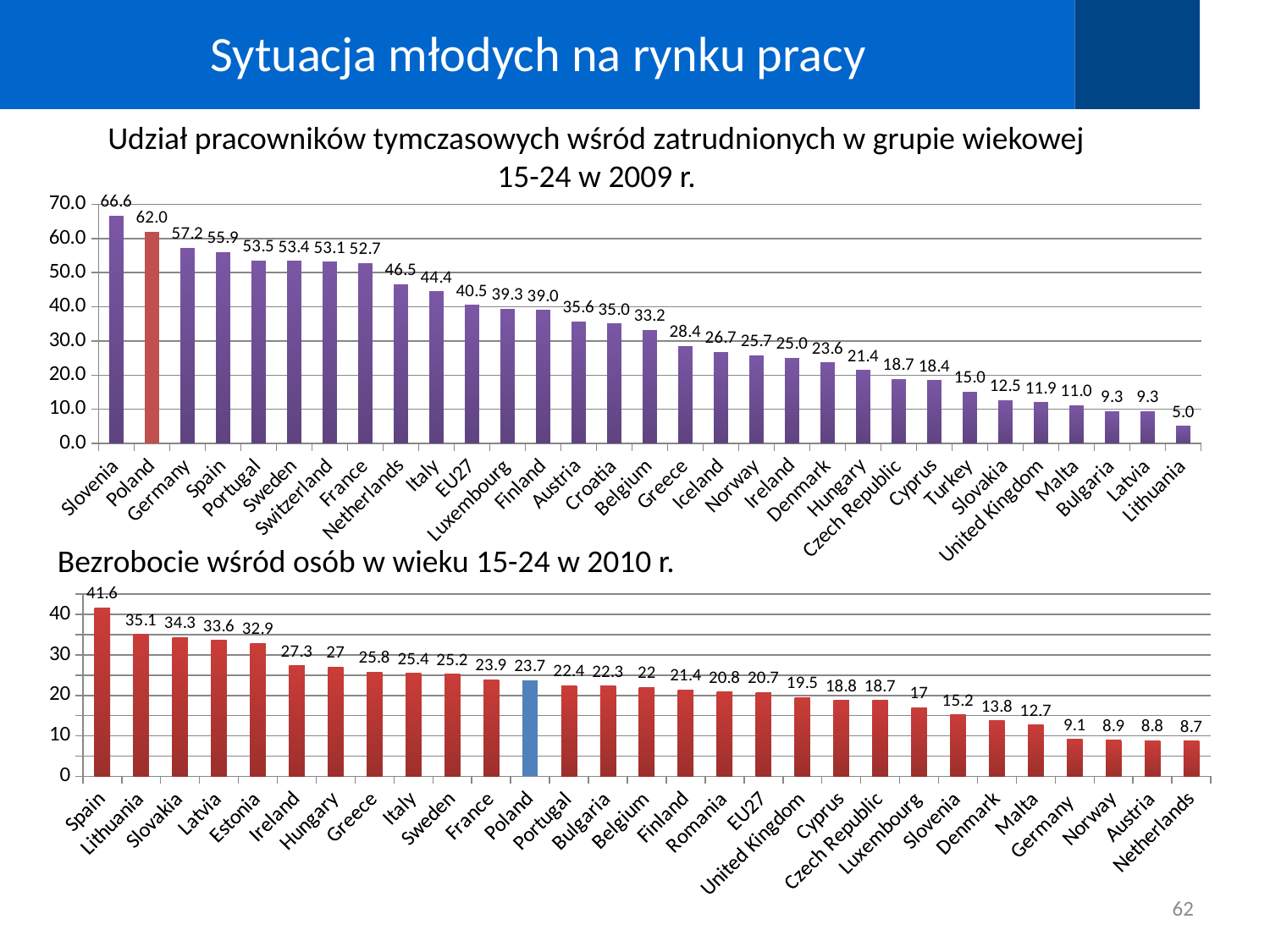
In the top chart (temporary workers share, 15-24, 2009), which country has the lowest value? Lithuania In the bottom chart (youth unemployment 15-24, 2010), what is the value for Poland? 23.7 In the top chart (temporary workers share, 15-24, 2009), what is the value for EU27? 40.5 In the top chart (temporary workers share, 15-24, 2009), which country has the highest value? Slovenia In the top chart (temporary workers share, 15-24, 2009), what is the difference between Slovenia and Poland? 4.6 In the bottom chart (youth unemployment 15-24, 2010), which country has the lowest value? Netherlands In the bottom chart (youth unemployment 15-24, 2010), what is the difference between Poland and EU27? 3 In the top chart (temporary workers share, 15-24, 2009), what is the value for Poland? 62.0 In the top chart (temporary workers share, 15-24, 2009), which is larger, Germany or Spain? Germany In the bottom chart (youth unemployment 15-24, 2010), what is the value for Spain? 41.6 In the bottom chart (youth unemployment 15-24, 2010), which bar is coloured blue instead of red? Poland What type of chart is the bottom chart (youth unemployment 15-24, 2010)? Bar chart